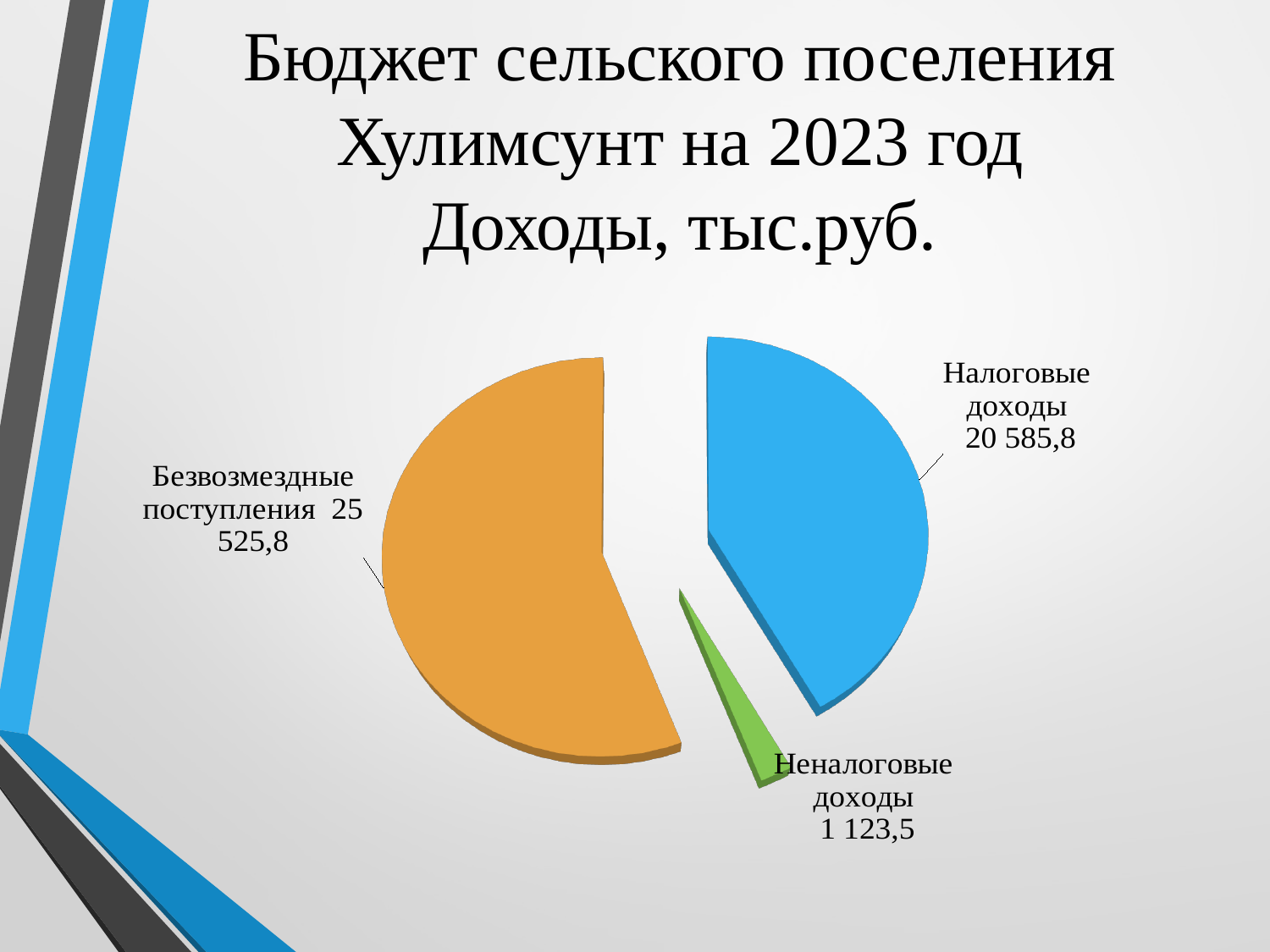
What is the difference between Безвозмездные поступления and Налоговые доходы? 4 940,0 What is the value for Безвозмездные поступления? 25 525,8 Which category has the largest value? Безвозмездные поступления What colour is the slice for Неналоговые доходы? Green What is the difference between Налоговые доходы and Неналоговые доходы? 19 462,3 What is the value for Неналоговые доходы? 1 123,5 How many slices does the pie chart have? 3 What kind of chart is shown on the slide? Pie chart Which category has the smallest value? Неналоговые доходы What is the value for Налоговые доходы? 20 585,8 What is the total of all three slices of the pie chart? 47 235,1 Which is larger, Налоговые доходы or Безвозмездные поступления? Безвозмездные поступления